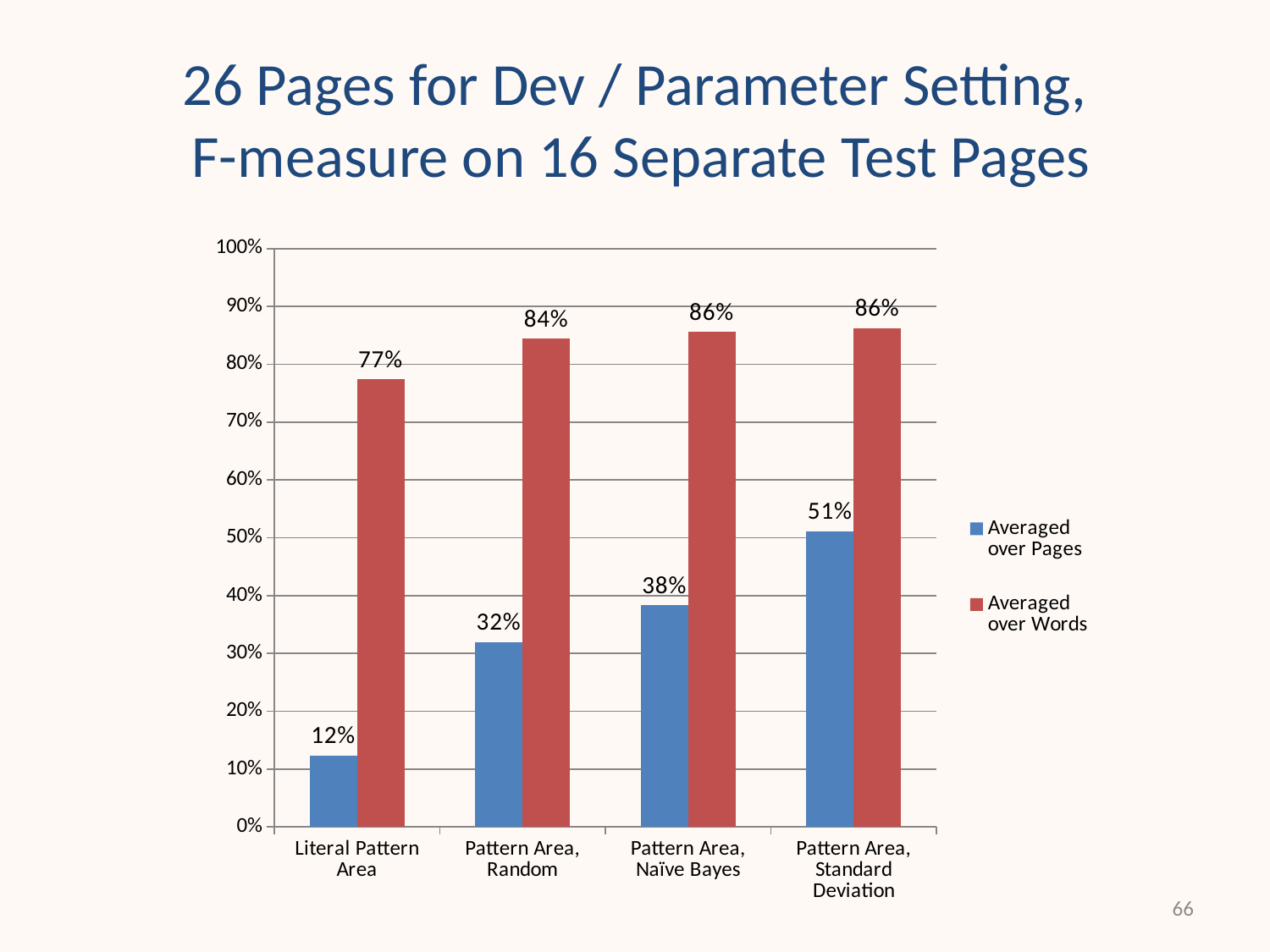
What is the difference between Averaged over Words and Averaged over Pages for Pattern Area, Naïve Bayes? 48% Which is larger for Pattern Area, Random: Averaged over Pages or Averaged over Words? Averaged over Words How many series does the legend list? 2 What kind of chart is shown on the slide? Bar chart How many categories are shown on the x axis? 4 Which category has the highest value for Averaged over Pages? Pattern Area, Standard Deviation What colour are the bars for the Averaged over Words series? Red Do the Averaged over Pages values rise or fall from left to right along the x axis? Rise What is the value for Averaged over Words for Pattern Area, Random? 84% What is the value for Averaged over Pages for Literal Pattern Area? 12% What is the value for Averaged over Pages for Pattern Area, Standard Deviation? 51% Which category has the lowest value for Averaged over Words? Literal Pattern Area